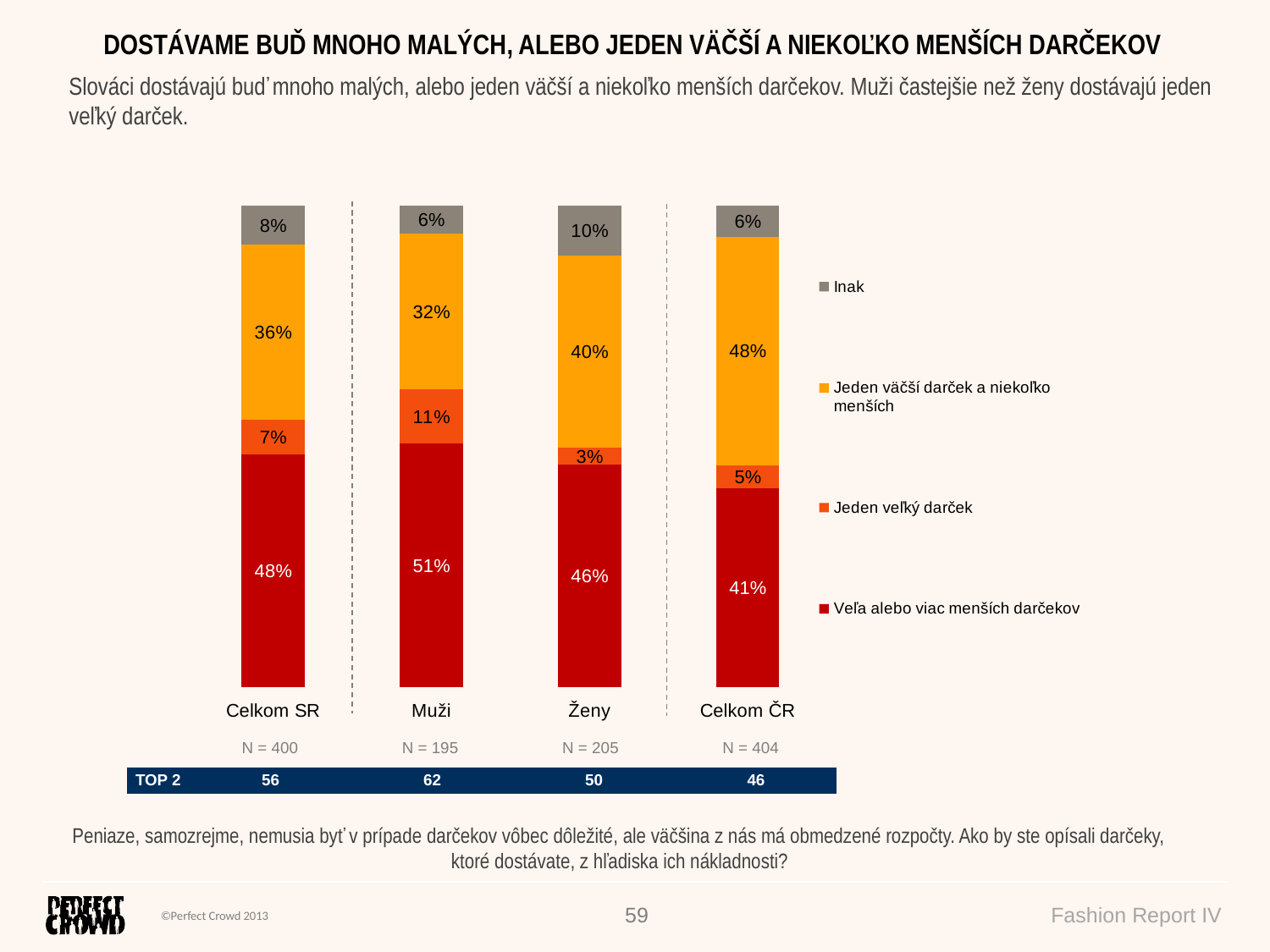
How many categories are shown on the x axis? 4 What is the value of 'Jeden väčší darček a niekoľko menších' for Celkom ČR? 48% Which is larger: the 'Inak' value for Ženy or for Celkom ČR? Ženy How many series does the legend list? 4 Which category has the lowest value for 'Veľa alebo viac menších darčekov'? Celkom ČR What is the difference between the 'Jeden väčší darček a niekoľko menších' values for Ženy and Muži? 8% Which category has the highest value for 'Jeden veľký darček'? Muži What is the TOP 2 value shown for Muži? 62 What is the value of 'Jeden veľký darček' for Ženy? 3% What is the value of 'Inak' for Celkom SR? 8% What is the value of 'Veľa alebo viac menších darčekov' for Muži? 51% What kind of chart is shown on the slide? stacked bar chart